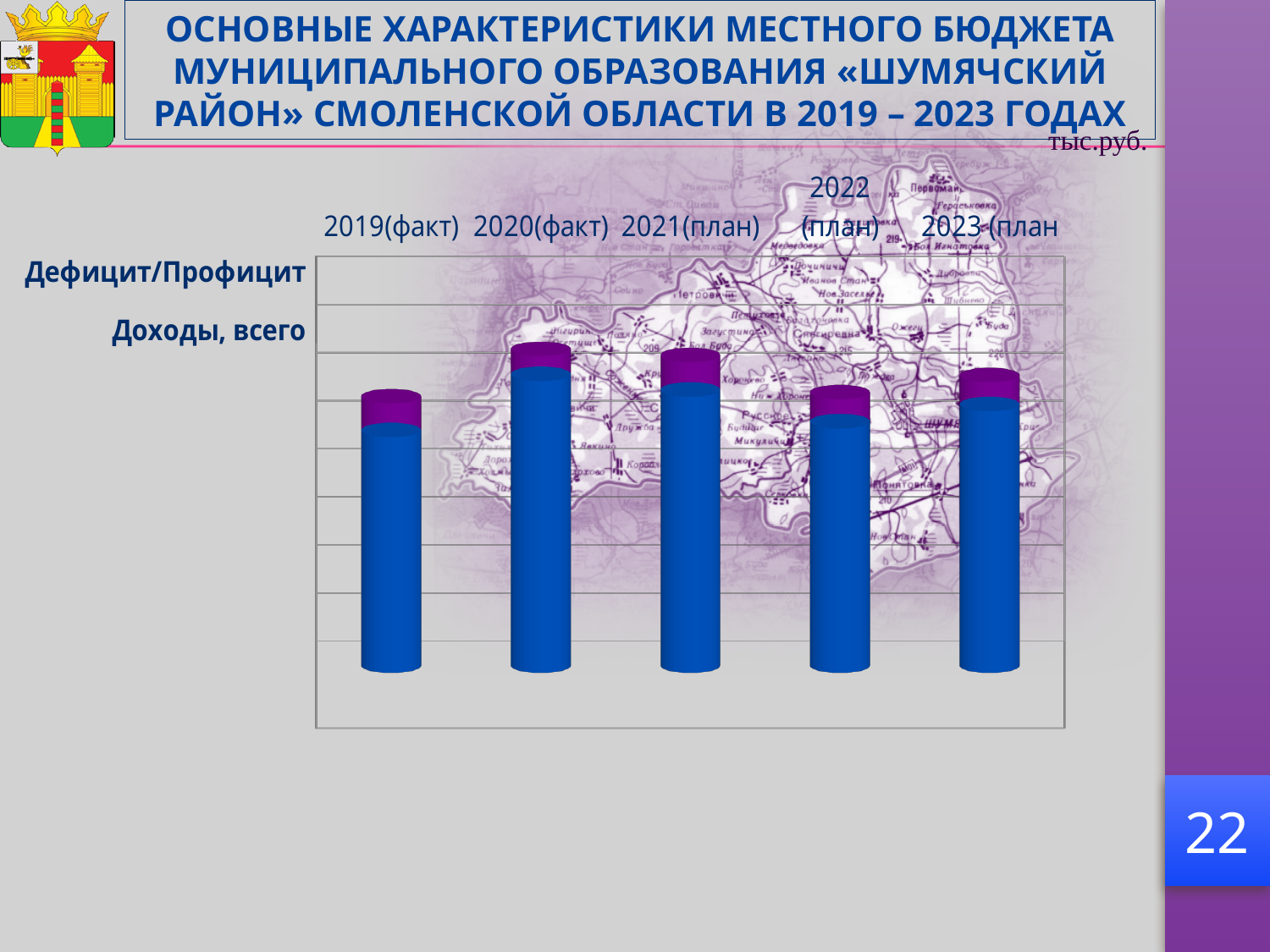
Is the total bar for 2020(факт) taller or shorter than the bar for 2019(факт)? taller What unit of measurement is indicated for the chart? тыс.руб. Is the total bar for 2023 (план) taller or shorter than the bar for 2019(факт)? taller Is the total bar for 2021(план) taller or shorter than the bar for 2022 (план)? taller How many categories (years) are plotted on the chart? 5 What is the label of the first category on the x axis? 2019(факт) What kind of chart is shown on the slide? bar chart Do the bar heights rise steadily from 2019 to 2023? no